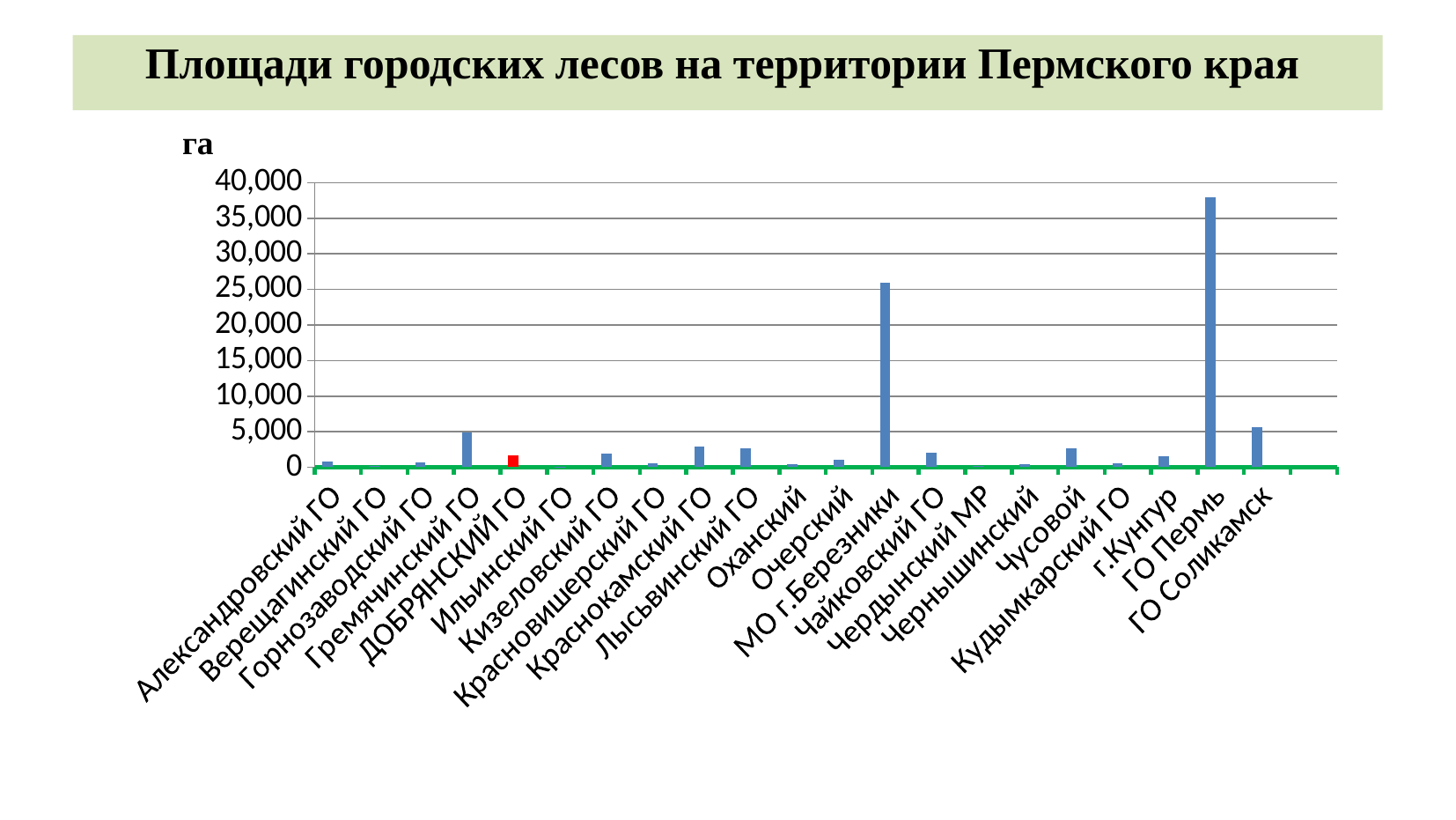
Which category has the highest value in the chart? ГО Пермь Is the value for МО г.Березники greater or less than 20,000? greater Is the value for ГО Соликамск greater or less than 10,000? less Which category's bar is coloured red instead of blue? ДОБРЯНСКИЙ ГО Is the value for Гремячинский ГО greater or less than 10,000? less Which has the larger value, ГО Пермь or МО г.Березники? ГО Пермь How many categories are shown on the x axis of the chart? 21 Which has the larger value, МО г.Березники or ГО Соликамск? МО г.Березники What is the title of the chart? Площади городских лесов на территории Пермского края What kind of chart is shown on the slide? bar chart